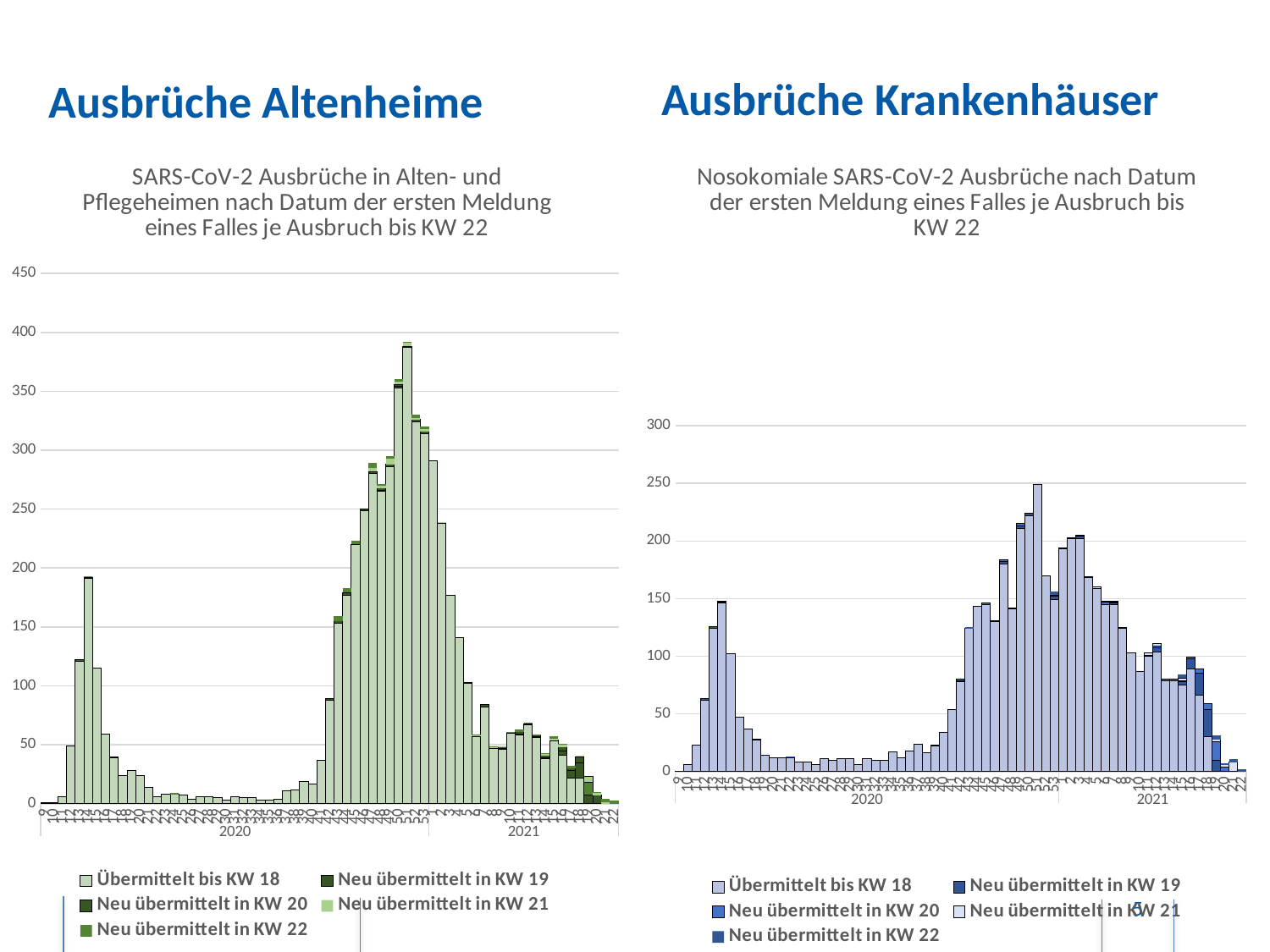
In the left chart ('Ausbrüche Altenheime'), is the value of the tallest bar greater or less than 350? greater In the right chart ('Ausbrüche Krankenhäuser'), is the value of the tallest bar greater or less than 200? greater What is the highest value shown on the y-axis of the right chart ('Ausbrüche Krankenhäuser')? 300 What is the highest value shown on the y-axis of the left chart ('Ausbrüche Altenheime')? 450 How many series does the legend of the right chart ('Ausbrüche Krankenhäuser') list? 5 In the left chart ('Ausbrüche Altenheime'), is the value of the tallest bar greater or less than 400? less How many series does the legend of the left chart ('Ausbrüche Altenheime') list? 5 What kind of chart is the left chart, 'Ausbrüche Altenheime'? bar chart Which chart has the taller peak bar: the left chart ('Ausbrüche Altenheime') or the right chart ('Ausbrüche Krankenhäuser')? Ausbrüche Altenheime What kind of chart is the right chart, 'Ausbrüche Krankenhäuser'? bar chart